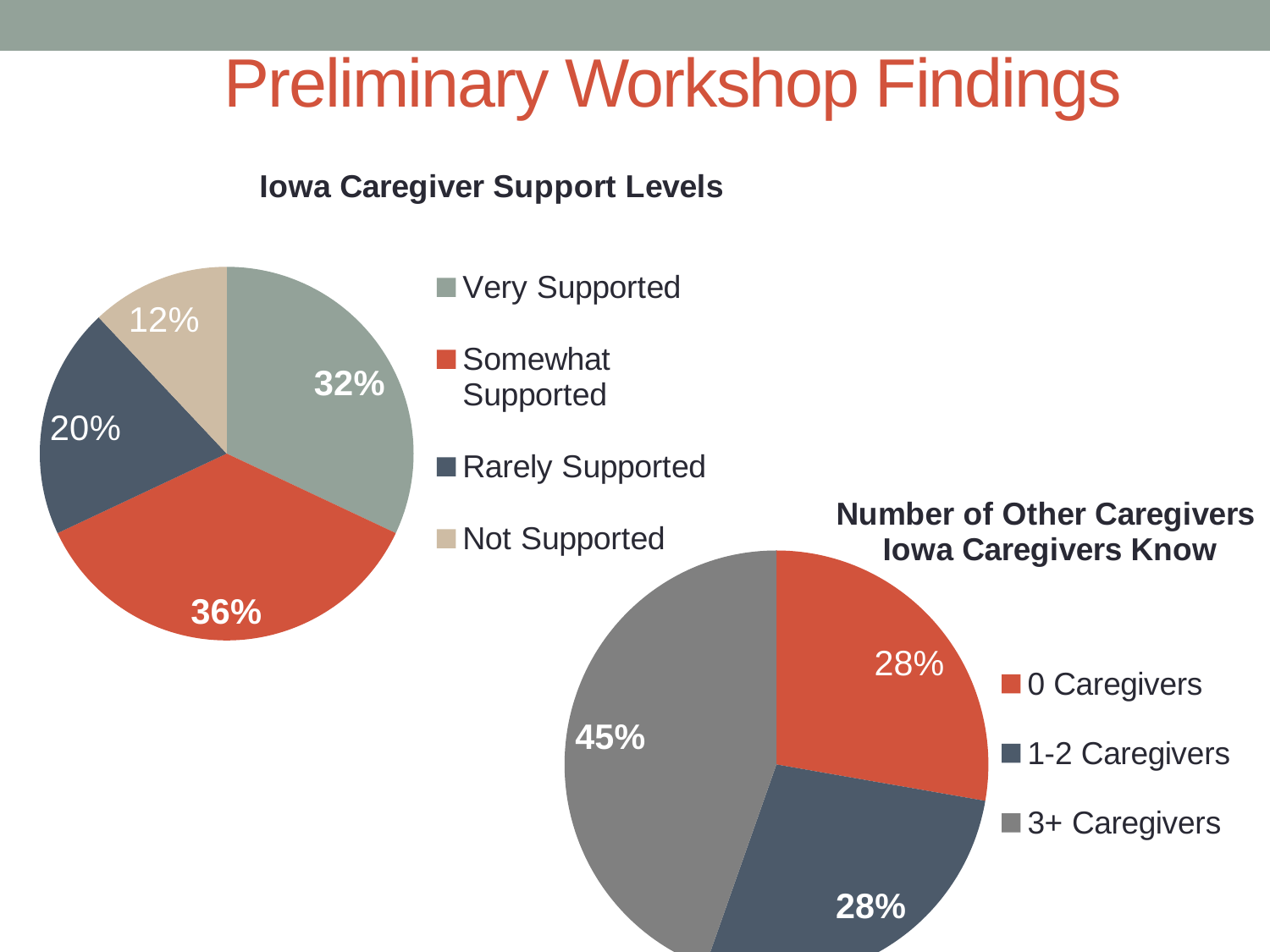
In the 'Number of Other Caregivers Iowa Caregivers Know' chart, what percentage of caregivers know 3+ Caregivers? 45% In the 'Iowa Caregiver Support Levels' chart, what percentage of caregivers are Somewhat Supported? 36% In the 'Iowa Caregiver Support Levels' chart, which category has the largest share? Somewhat Supported In the 'Iowa Caregiver Support Levels' chart, which category has the smallest share? Not Supported In the 'Number of Other Caregivers Iowa Caregivers Know' chart, what colour is the 0 Caregivers slice? Orange-red In the 'Number of Other Caregivers Iowa Caregivers Know' chart, which category has the largest share? 3+ Caregivers In the 'Number of Other Caregivers Iowa Caregivers Know' chart, what percentage of caregivers know 0 Caregivers? 28% In the 'Iowa Caregiver Support Levels' chart, how many categories does the legend list? 4 In the 'Iowa Caregiver Support Levels' chart, what percentage of caregivers are Not Supported? 12% In the 'Number of Other Caregivers Iowa Caregivers Know' chart, what is the difference between the 3+ Caregivers share and the 1-2 Caregivers share? 17% What kind of chart is 'Iowa Caregiver Support Levels'? Pie chart In the 'Iowa Caregiver Support Levels' chart, what is the difference between the Very Supported and Rarely Supported shares? 12%